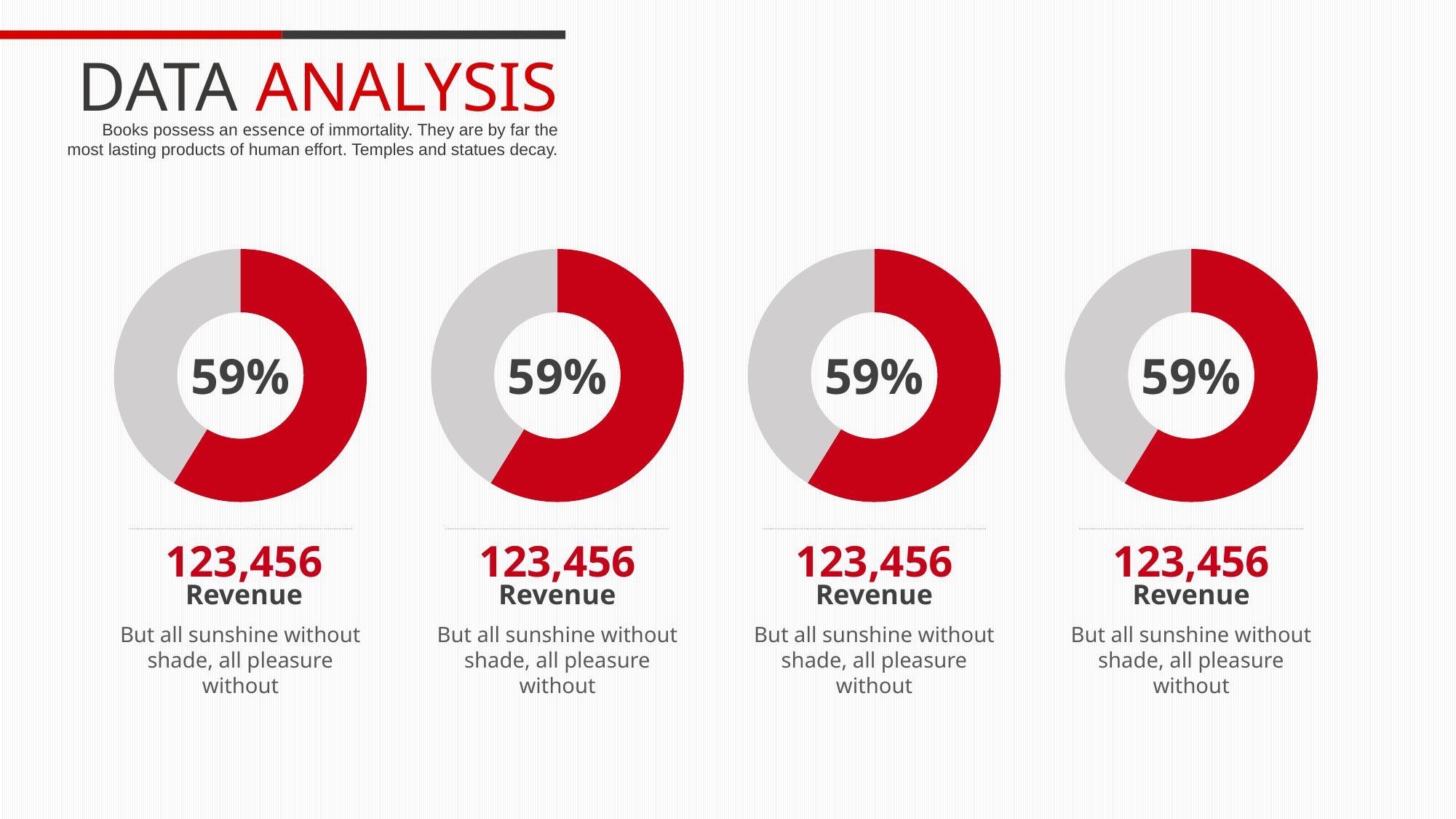
What kind of chart is used four times across the middle of the slide? Donut chart Do the four donut charts show the same percentage or different percentages? The same (59%) How many segments does each donut chart have? 2 What percentage is shown in the centre of the rightmost donut chart? 59% How many donut charts are on the slide? 4 What is the title of the slide containing the donut charts? DATA ANALYSIS What revenue figure is printed below the third donut chart from the left? 123,456 Is the red share in the leftmost donut chart greater or less than 50%? greater What label appears directly under the figure 123,456 beneath each donut chart? Revenue In the second donut chart from the left, what share of the ring is filled in red? 59% What percentage is shown in the centre of the leftmost donut chart? 59% What colour is the filled (59%) portion of each donut chart? Red